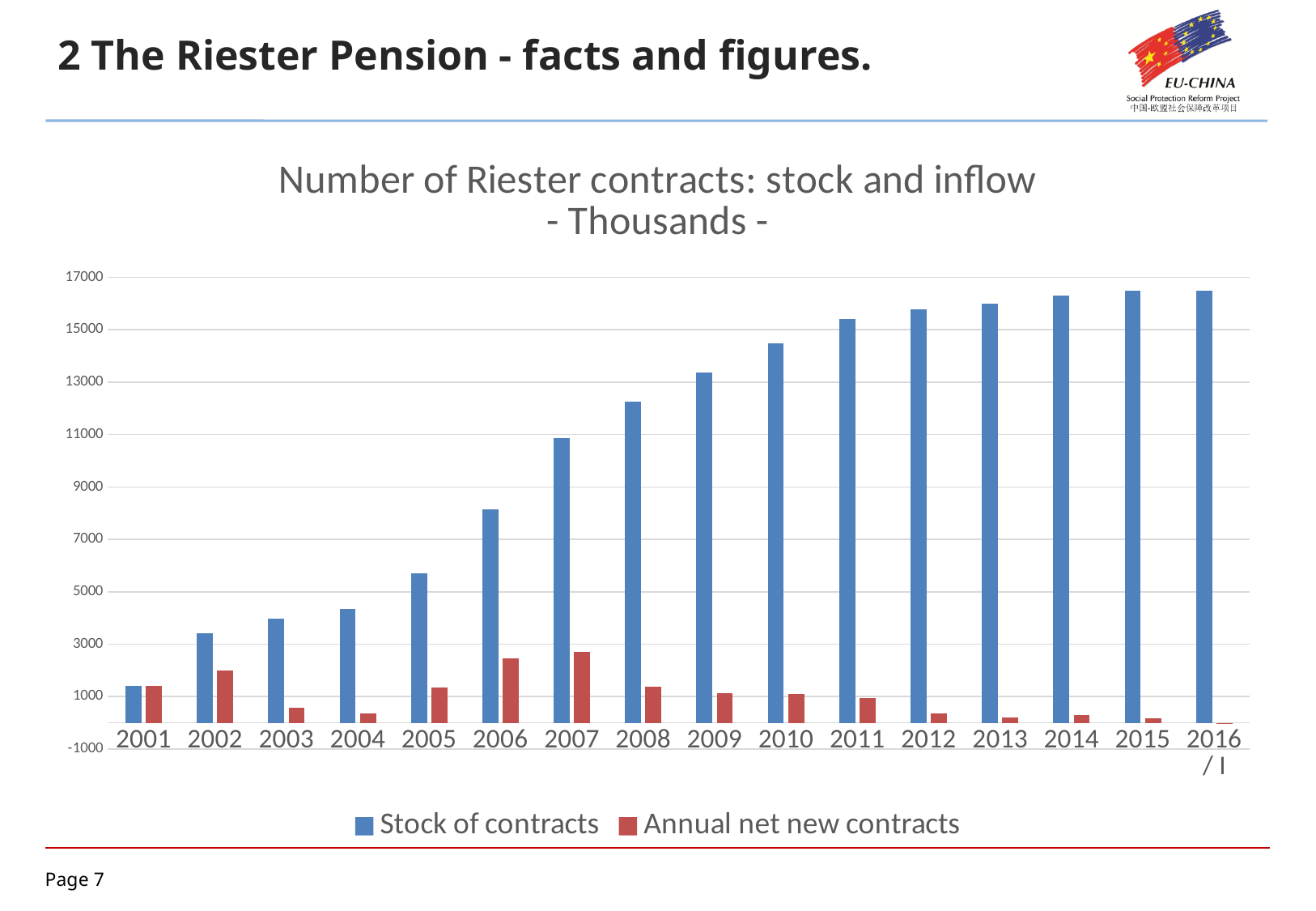
How many years are shown along the x axis? 16 Is the value for Annual net new contracts in 2007 greater or less than 3000? less Which year has the lowest value for Stock of contracts? 2001 Which is larger, Annual net new contracts in 2002 or in 2003? 2002 Is the value for Stock of contracts in 2004 greater or less than 5000? less What type of chart is shown on the slide? Bar chart Is the value for Annual net new contracts in 2002 greater or less than 1000? greater Which year has the highest value for Annual net new contracts? 2007 Does the Stock of contracts rise or fall from 2001 to 2016? Rises How many series does the legend list? 2